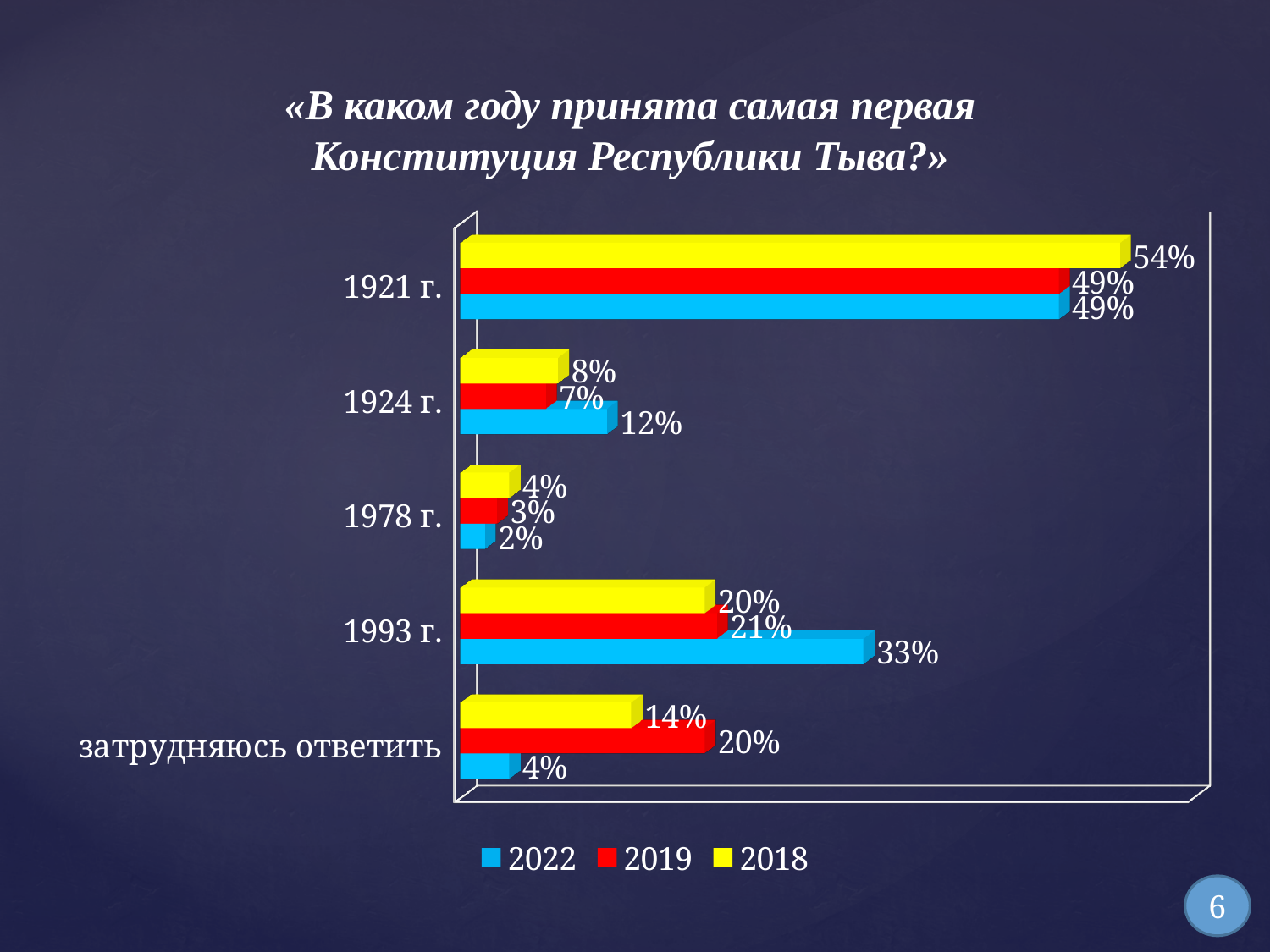
What type of chart is shown on the slide? bar chart For the category 1924 г., which series has the larger value, 2022 or 2019? 2022 What is the difference between the 2022 and 2018 values for the category 1993 г.? 13% What is the value for 2018 in the category 1921 г.? 54% What is the value for 2019 in the category затрудняюсь ответить? 20% What is the value for 2022 in the category 1978 г.? 2% Which colour represents the 2019 series in the legend? red What is the value for 2022 in the category 1993 г.? 33% How many series does the legend list? 3 Which category has the highest value for the 2022 series? 1921 г. Which category has the lowest value for the 2018 series? 1978 г. How many categories are shown on the chart? 5